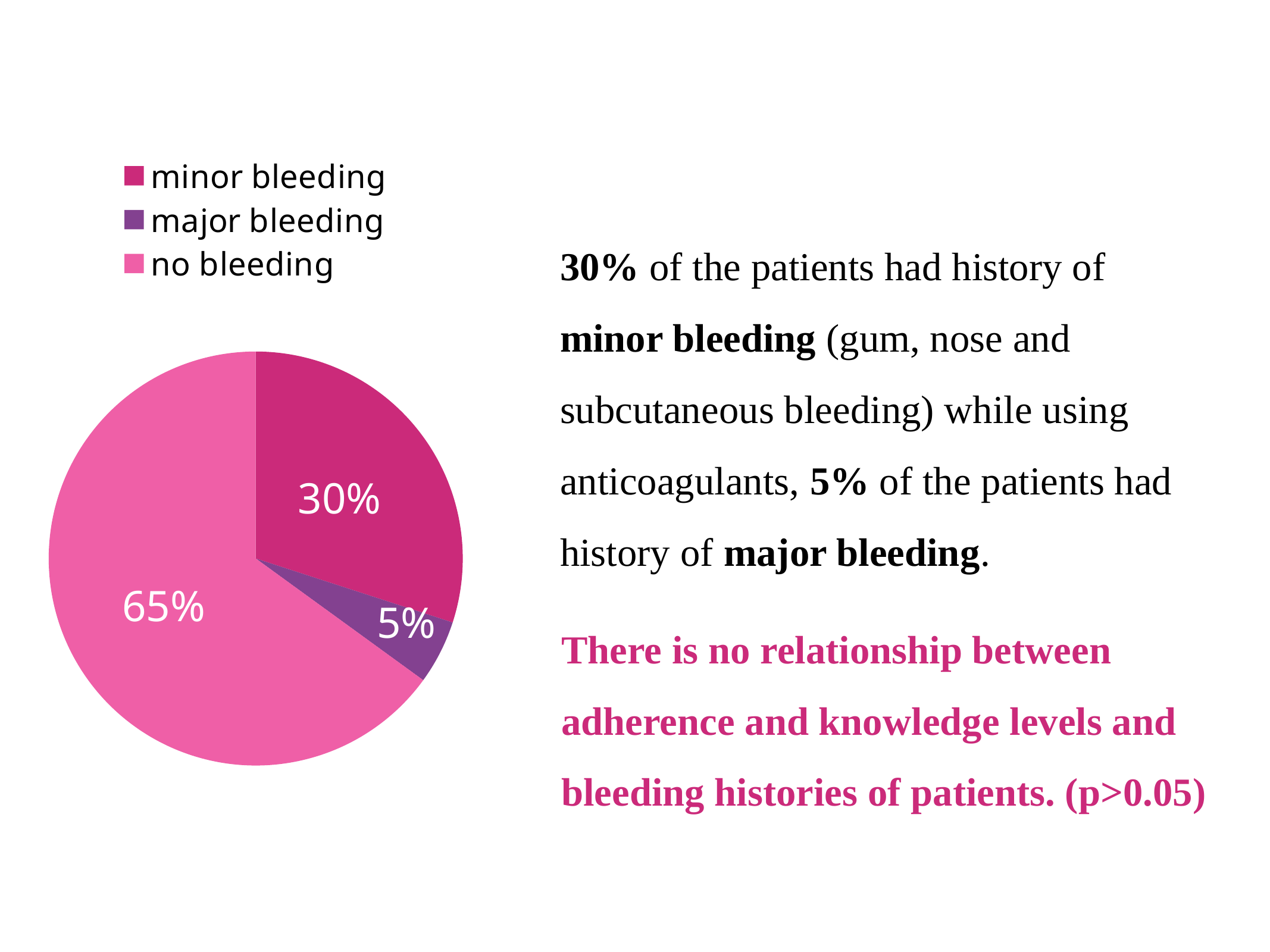
Which category has the largest slice of the pie? no bleeding What share of the pie is labelled "major bleeding"? 5% What is the difference in percentage points between the "minor bleeding" and "major bleeding" slices? 25 What is the difference in percentage points between the "no bleeding" and "minor bleeding" slices? 35 What kind of chart is shown on the slide? pie chart Which slice is larger, "minor bleeding" or "major bleeding"? minor bleeding What share of the pie is labelled "no bleeding"? 65% What share of the pie is labelled "minor bleeding"? 30% Which legend entry is shown in purple? major bleeding How many entries does the legend list? 3 How many categories does the pie chart have? 3 Which category has the smallest slice of the pie? major bleeding